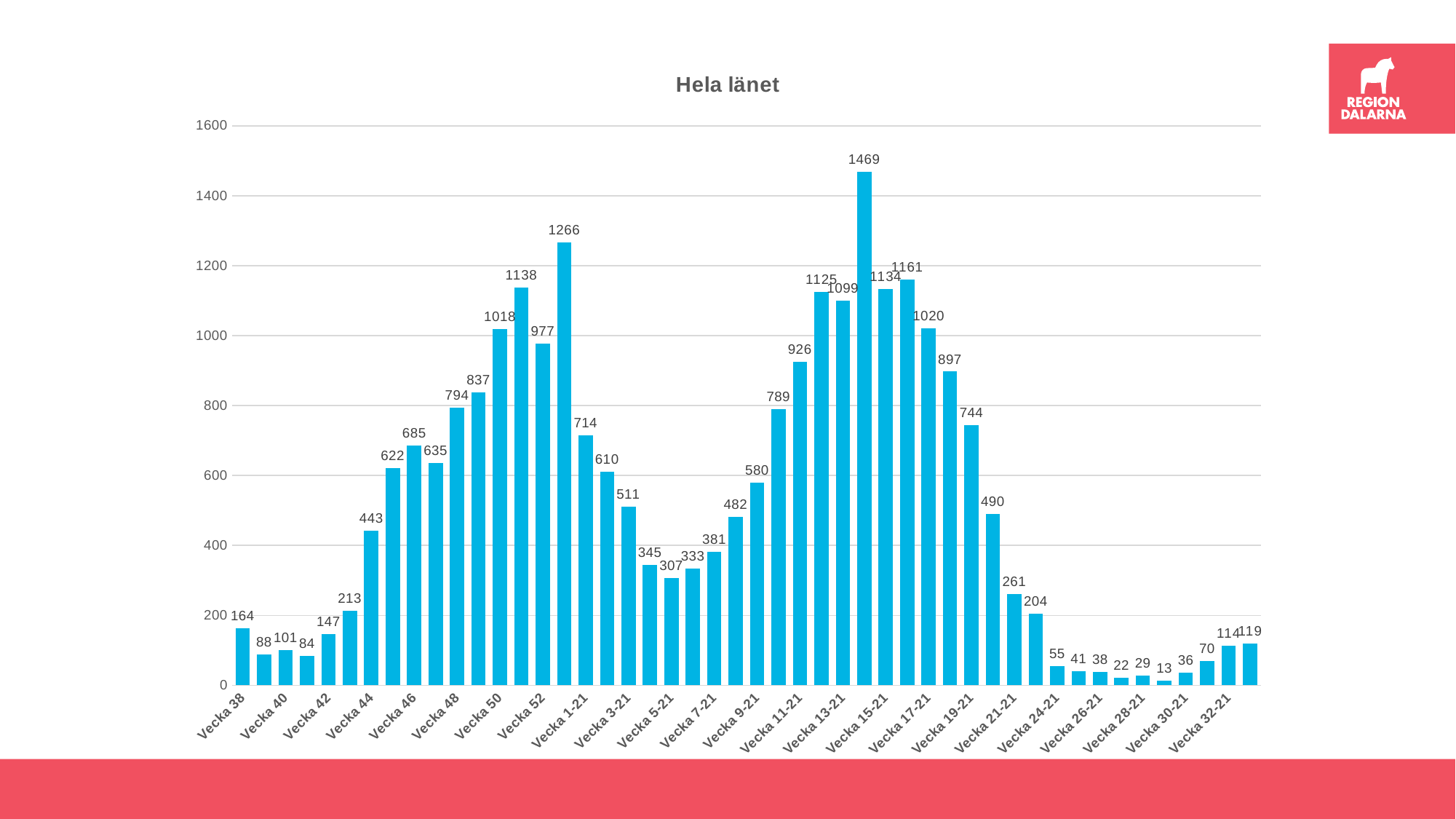
What is the lowest value shown in the chart? 13 What is the title of the chart? Hela länet Do the values rise or fall from Vecka 17-21 to Vecka 21-21? fall Is the value for Vecka 44 greater or less than 400? greater What is the highest value shown in the chart? 1469 What is the difference between the values for Vecka 52 and Vecka 1-21? 263 What is the value for Vecka 38? 164 Which is larger, the value for Vecka 11-21 or the value for Vecka 19-21? Vecka 11-21 What is the value for Vecka 1-21? 714 What is the value for Vecka 15-21? 1134 What type of chart is shown on the slide? bar chart What is the value for Vecka 50? 1018